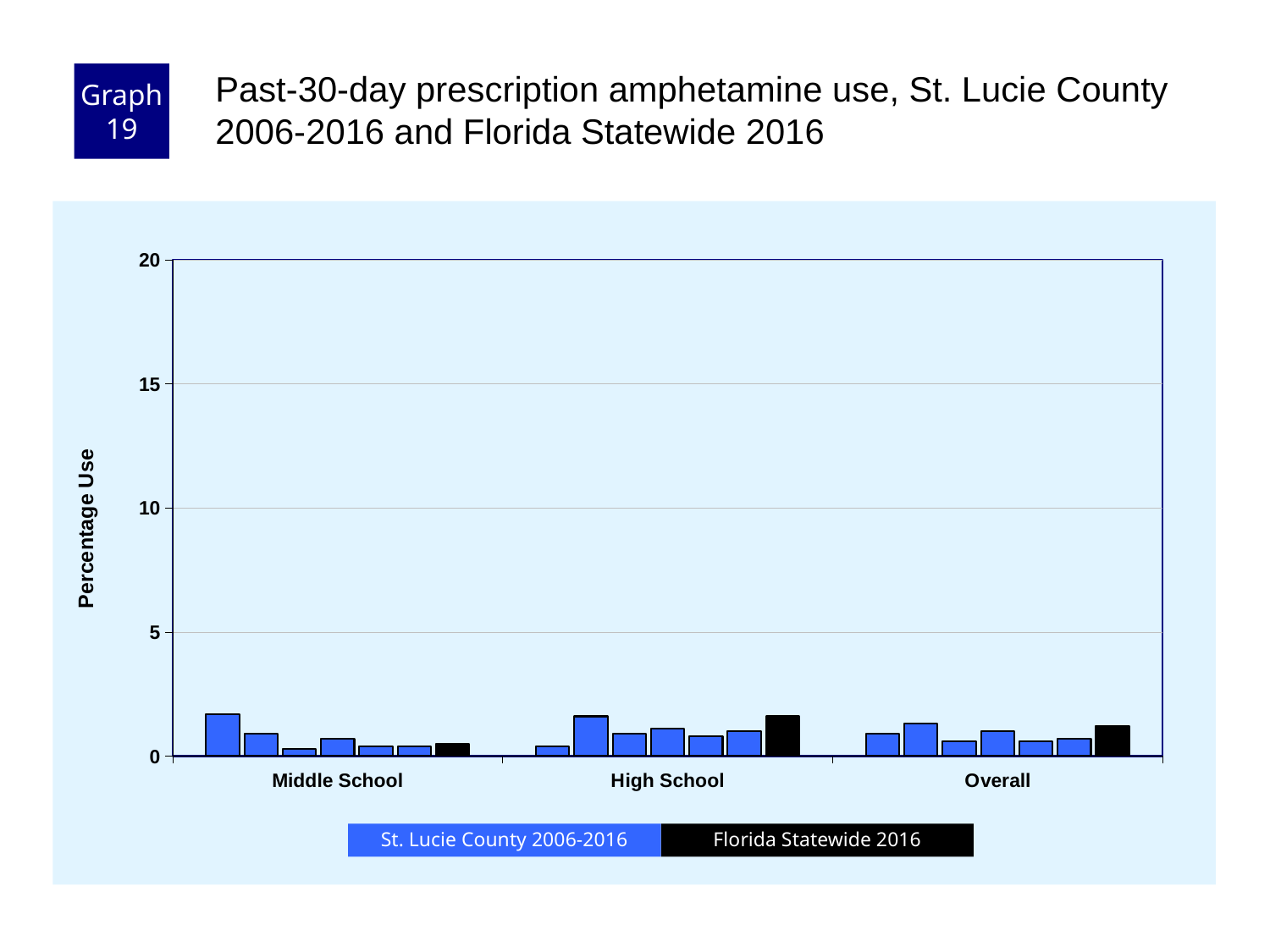
For the Florida Statewide 2016 series, which category has the lowest value? Middle School What kind of chart is shown on the slide? bar chart What is the title of the chart? Past-30-day prescription amphetamine use, St. Lucie County 2006-2016 and Florida Statewide 2016 Is the Florida Statewide 2016 value for Middle School greater or less than 5? less For the Florida Statewide 2016 series, which is larger: the value for Overall or the value for Middle School? Overall Is the Florida Statewide 2016 value for Overall greater or less than 5? less Is the Florida Statewide 2016 value for High School greater or less than 5? less How many categories are shown on the x axis? 3 For the Florida Statewide 2016 series, which category has the highest value? High School For the Florida Statewide 2016 series, which is larger: the value for High School or the value for Middle School? High School How many series does the legend list? 2 What is the label on the y axis? Percentage Use